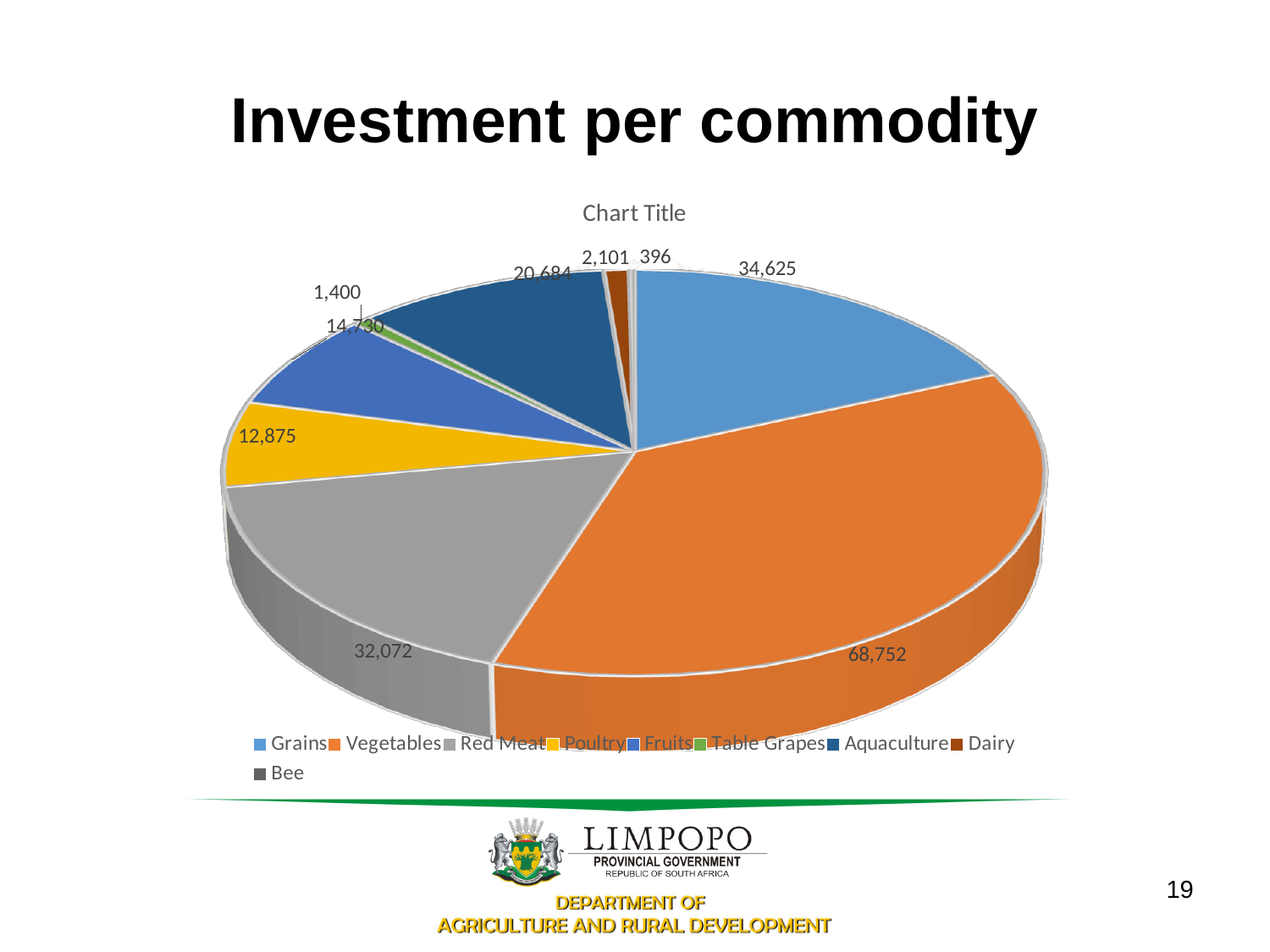
What is the value for Vegetables in the pie chart? 68,752 What is the value for Poultry in the pie chart? 12,875 What is the value for Grains in the pie chart? 34,625 What kind of chart is shown on the slide? pie chart Which commodity has the smallest slice of the pie chart? Bee What is the value for Red Meat in the pie chart? 32,072 What is the value for Bee in the pie chart? 396 Which commodity has the largest slice of the pie chart? Vegetables What is the difference between the values for Vegetables and Grains? 34,127 What is the value for Dairy in the pie chart? 2,101 Which is larger, the value for Grains or the value for Red Meat? Grains How many commodities are listed in the legend of the pie chart? 9